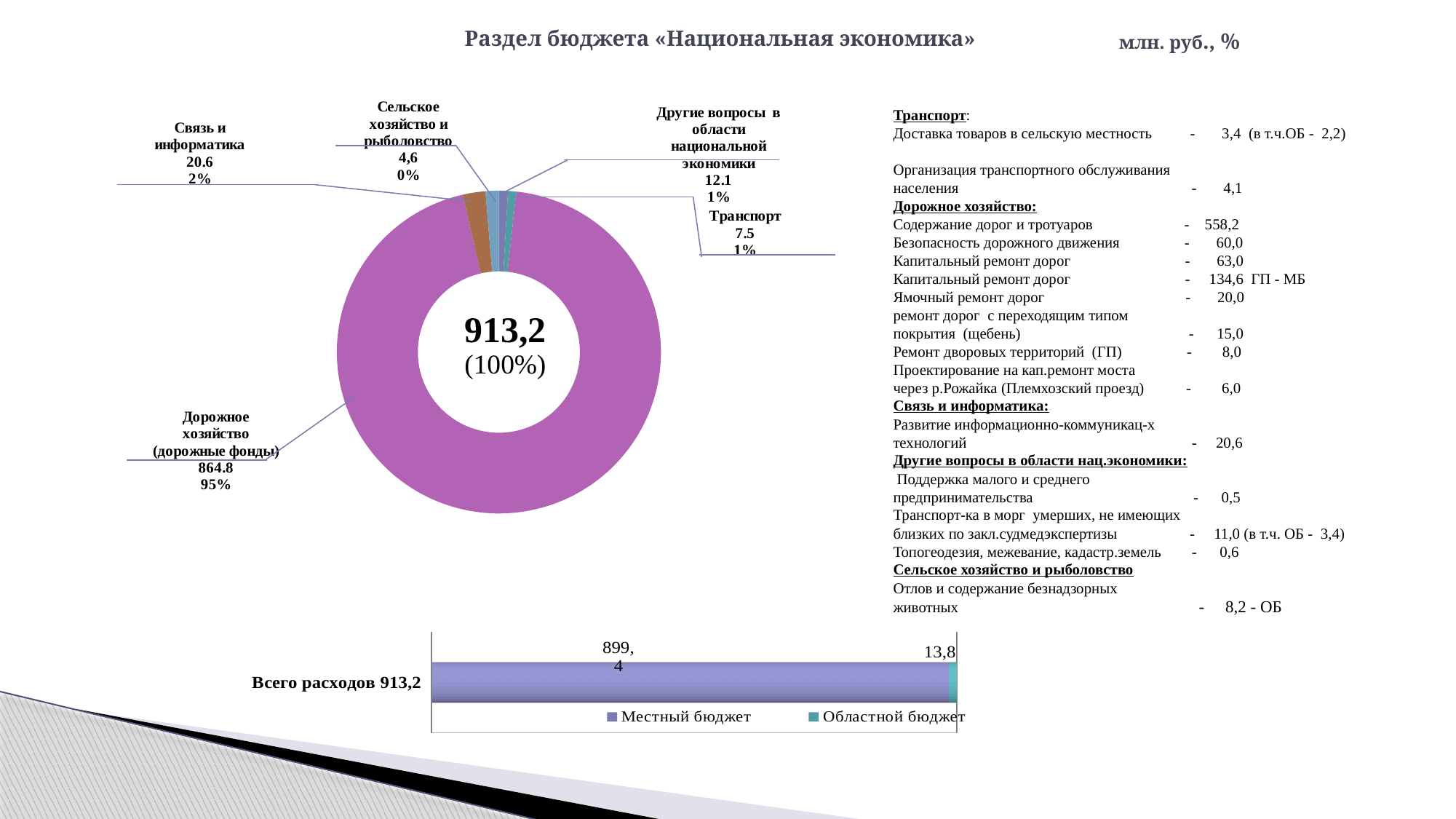
In the doughnut chart, which category has the largest value? Дорожное хозяйство (дорожные фонды) In the doughnut chart, what percentage share is shown for Сельское хозяйство и рыболовство? 0% In the doughnut chart, which category has the smallest value? Сельское хозяйство и рыболовство In the bar chart at the bottom, what value is shown for Местный бюджет? 899,4 In the doughnut chart, what value is shown for Транспорт? 7.5 In the doughnut chart, what percentage share is shown for Дорожное хозяйство (дорожные фонды)? 95% What total value is shown in the centre of the doughnut chart? 913,2 In the doughnut chart, which is larger: Связь и информатика or Другие вопросы в области национальной экономики? Связь и информатика In the doughnut chart, what value is shown for Связь и информатика? 20.6 In the bar chart at the bottom, what value is shown for Областной бюджет? 13,8 In the doughnut chart, what value is shown for Дорожное хозяйство (дорожные фонды)? 864.8 How many categories does the doughnut chart show? 5